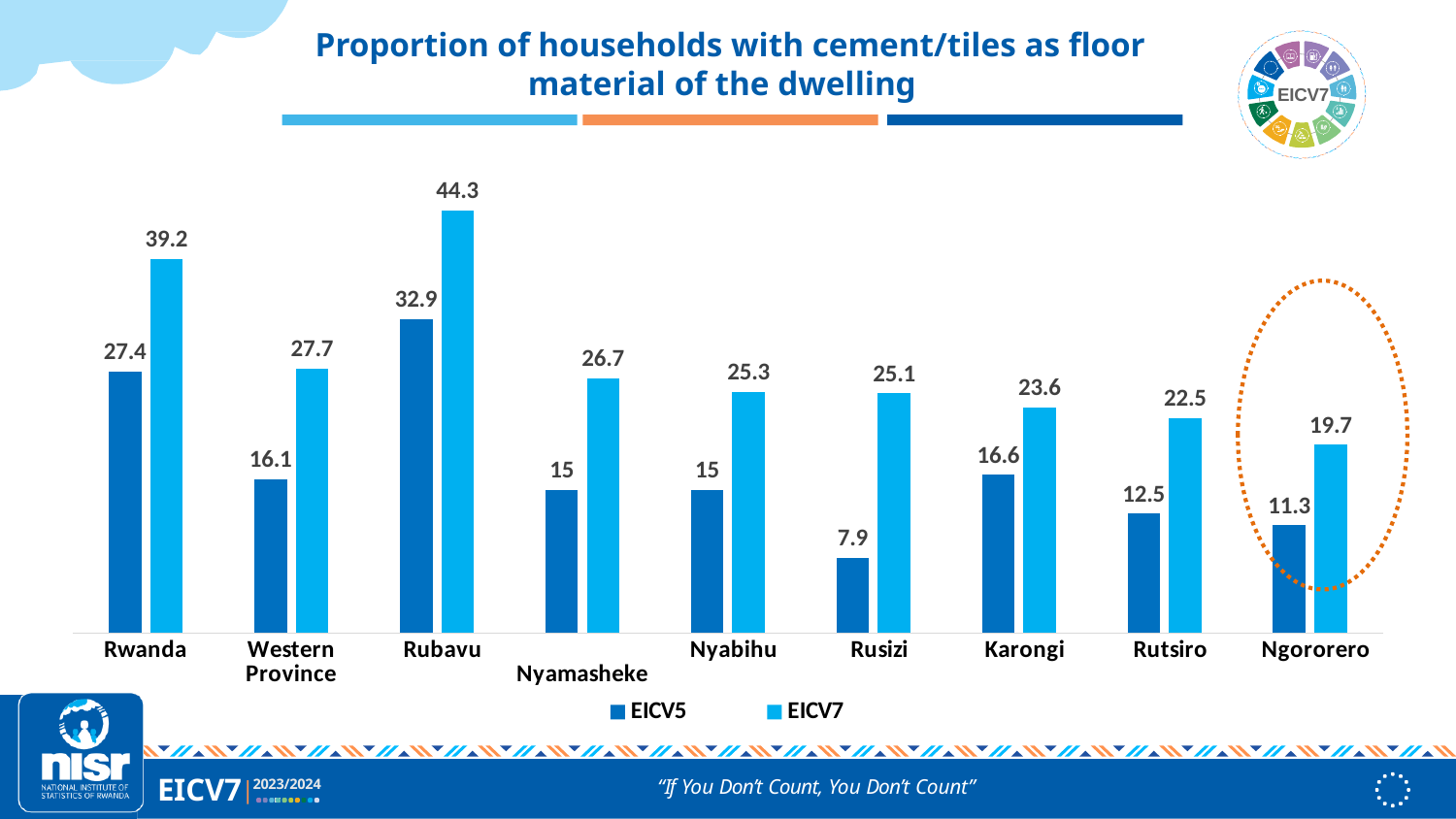
Which category is highlighted with a dotted orange circle? Ngororero How many series does the legend list? 2 What kind of chart is shown on the slide? Bar chart What is the title of the chart? Proportion of households with cement/tiles as floor material of the dwelling Which category has the highest EICV7 value? Rubavu What is the EICV5 value for Rusizi? 7.9 What is the difference between the EICV7 and EICV5 values for Rwanda? 11.8 What is the EICV7 value for Ngororero? 19.7 What is the EICV7 value for Rubavu? 44.3 Which is larger, the EICV7 value for Nyabihu or the EICV7 value for Rusizi? Nyabihu How many categories are shown on the x axis? 9 Which category has the lowest EICV5 value? Rusizi